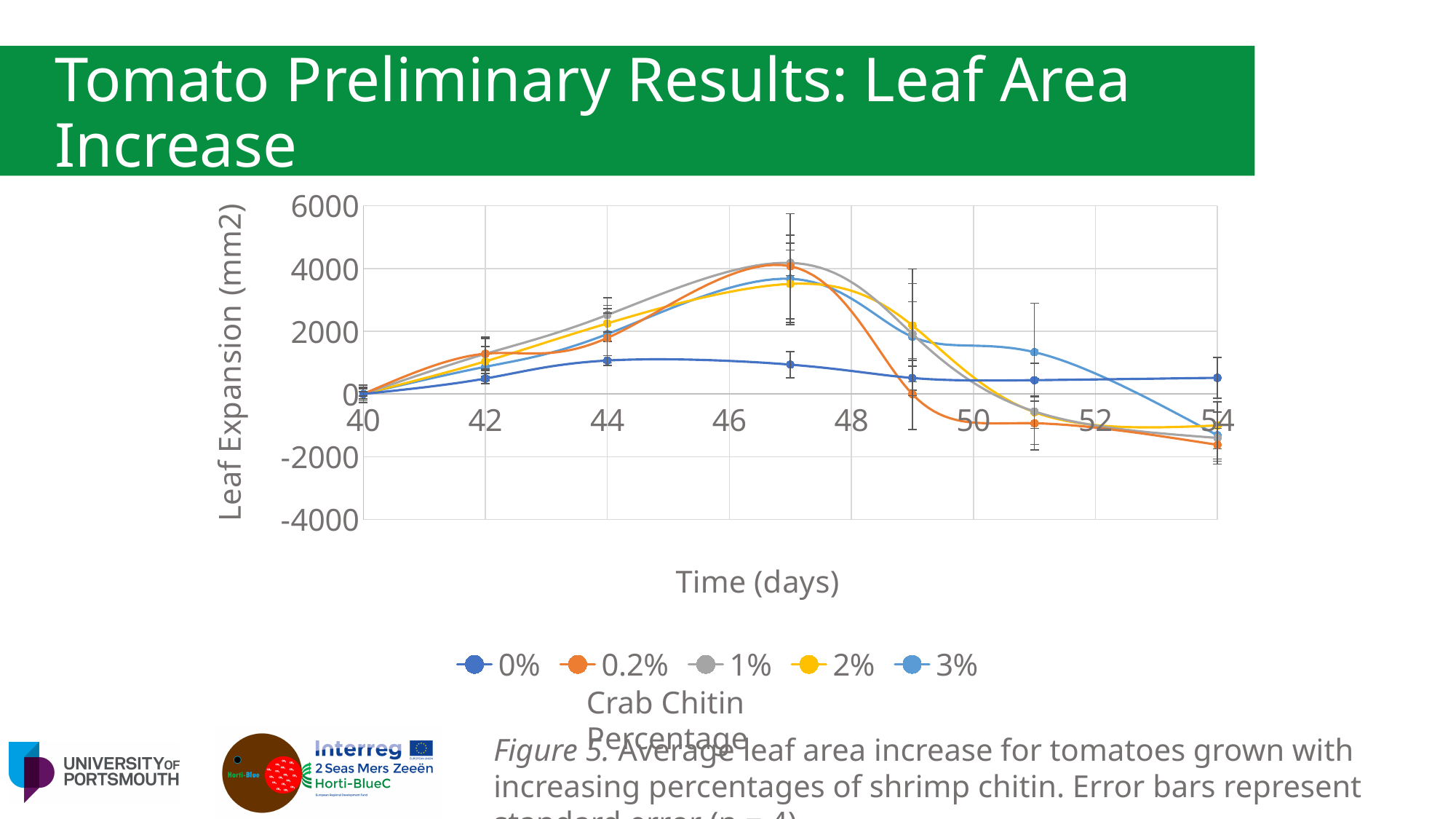
Is the value for the 1% series at day 47 greater or less than 2000? greater How many series does the legend list? 5 What is the title of the x axis? Time (days) Is the value for the 0.2% series at day 54 greater or less than 0? less At day 47, which is larger: the 0% series or the 1% series? 1% What is the title of the y axis? Leaf Expansion (mm2) At day 54, which is larger: the 0% series or the 0.2% series? 0% Which series has the lowest value at day 47? 0% Does the 0.2% series rise or fall between day 47 and day 54? fall What kind of chart is shown on the slide? line chart Is the value for the 0% series at day 47 greater or less than 2000? less